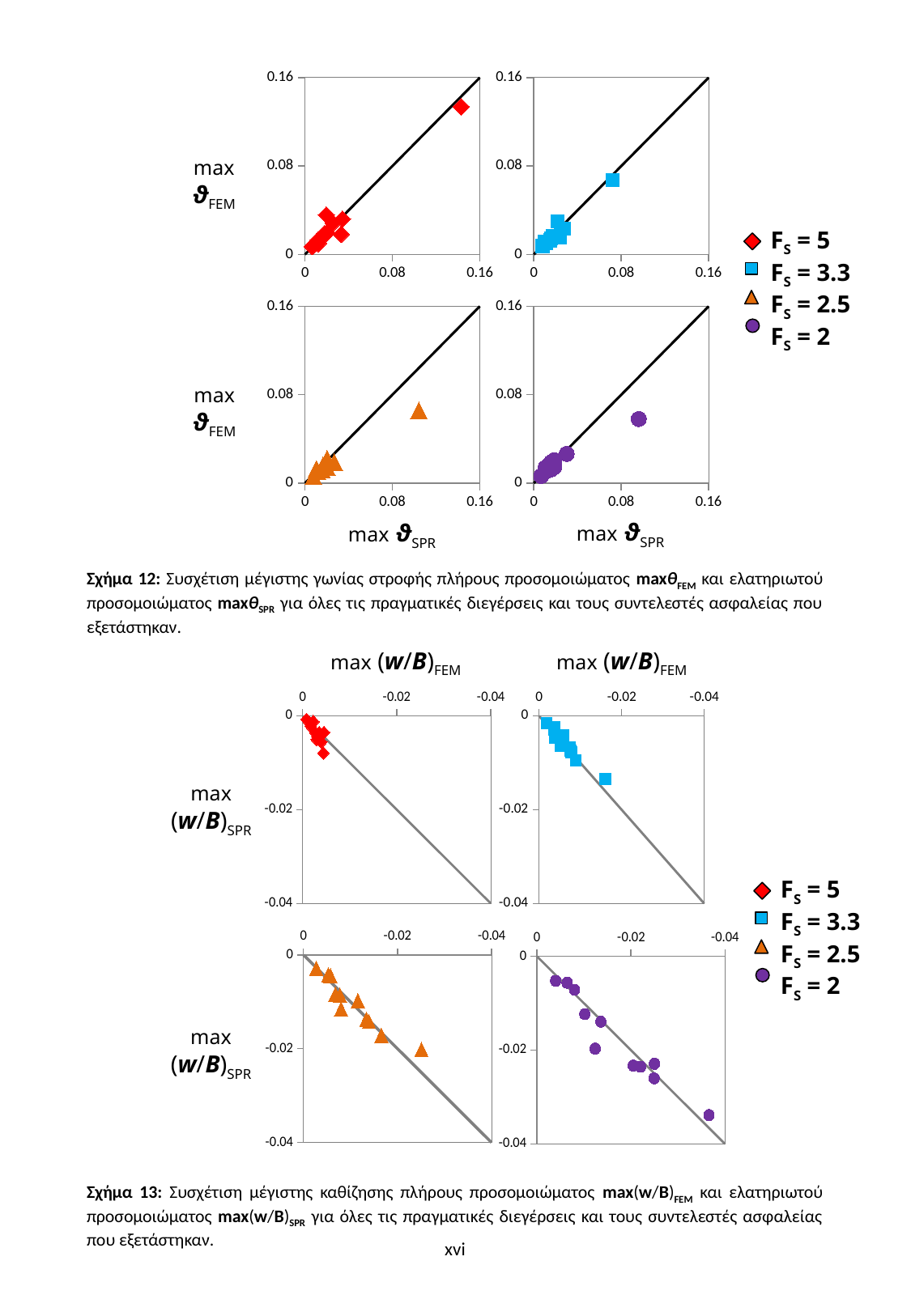
In Figure 13, in the Fs = 5 (red diamond) panel, do all the points lie above or below the -0.02 tick on the vertical axis? above What is the maximum value shown on the axes of the Figure 12 panels? 0.16 In Figure 13, in the Fs = 2 (purple circle) panel, does the lowest point lie above or below the -0.02 tick on the vertical axis? below In Figure 12, in the Fs = 2 (purple circle) panel, is the max θ_FEM value of the isolated point far from the line greater or less than 0.08? less In Figure 13, which series has points reaching the largest magnitude of max(w/B)_SPR? Fs = 2 How many scatter panels make up Figure 12? 4 What are the legend entries shown next to Figure 13? Fs = 5, Fs = 3.3, Fs = 2.5, Fs = 2 What kind of chart are the panels in Figure 12 (Σχήμα 12)? Scatter chart How many series does the legend of Figure 12 list? 4